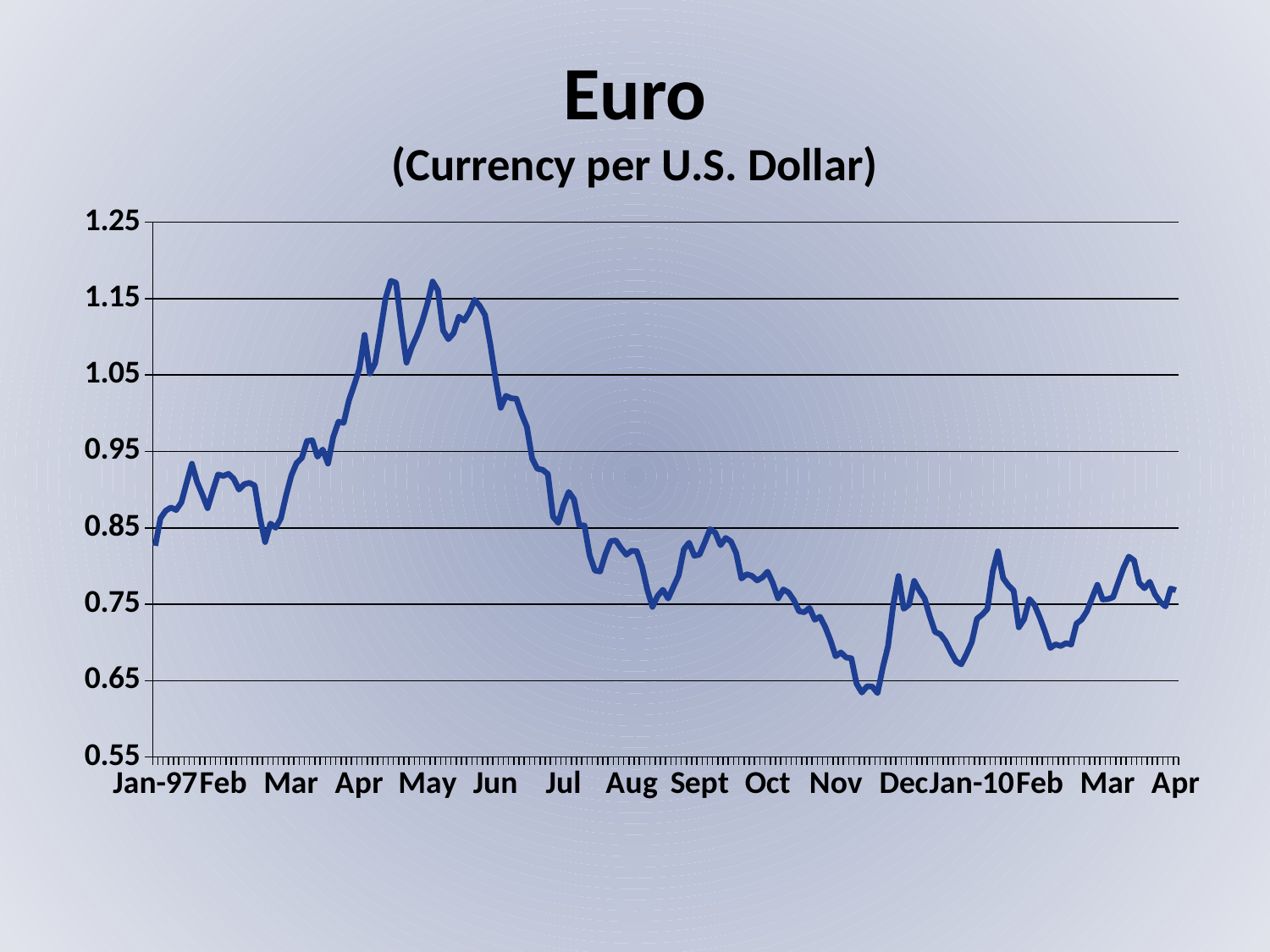
Near which month label does the line reach its highest point? May Is the peak value of the line greater or less than 1.15? greater What is the title of the chart? Euro (Currency per U.S. Dollar) Is the value at Jan-10 greater or less than 0.85? less Does the line generally rise or fall between May and Nov? fall What kind of chart is shown on the slide? Line chart Is the value at Jan-97 greater or less than 0.95? less Does the line generally rise or fall between Jan-97 and May? rise How many lines are plotted on the chart? 1 How many month labels are shown along the x axis? 16